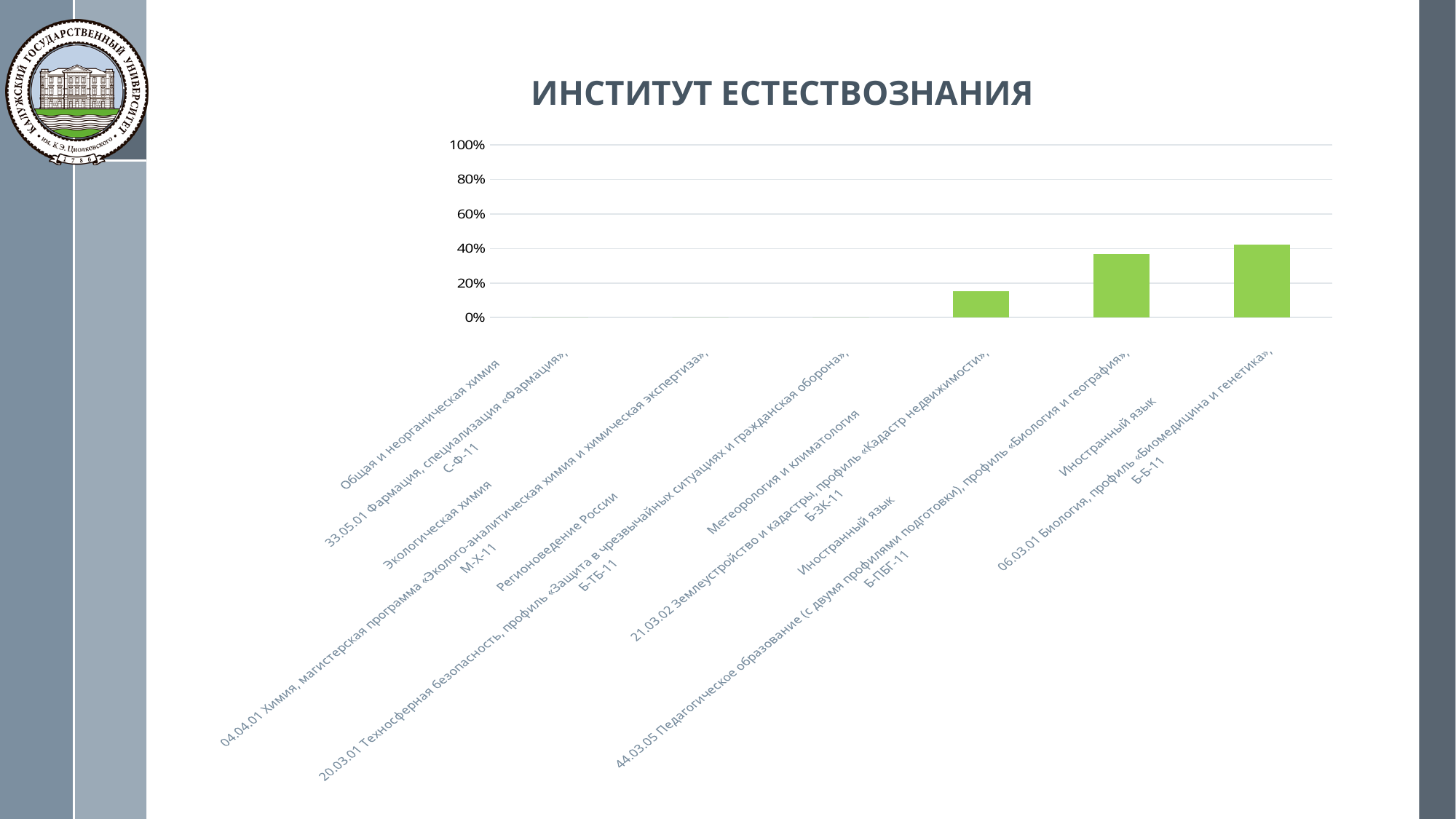
Which of the three visible bars is the lowest? Б-ЗК-11 (21.03.02 Землеустройство и кадастры) Is the value for the category Б-Б-11 (06.03.01 Биология) greater or less than 60%? less Is the value for the category Б-ПБГ-11 (44.03.05 Педагогическое образование) greater or less than 20%? greater Is the value for the category Б-ЗК-11 (21.03.02 Землеустройство и кадастры) greater or less than 20%? less What is the title of the slide with the chart? ИНСТИТУТ ЕСТЕСТВОЗНАНИЯ Which is larger: the value for Б-ЗК-11 or the value for Б-ПБГ-11? Б-ПБГ-11 Do the visible bar values rise or fall from left to right along the x axis? rise What colour are the bars in the chart? green Which category has the highest bar in the chart? Б-Б-11 (06.03.01 Биология, профиль «Биомедицина и генетика») How many categories are shown on the x axis of the chart? 6 What kind of chart is shown on the slide? bar chart